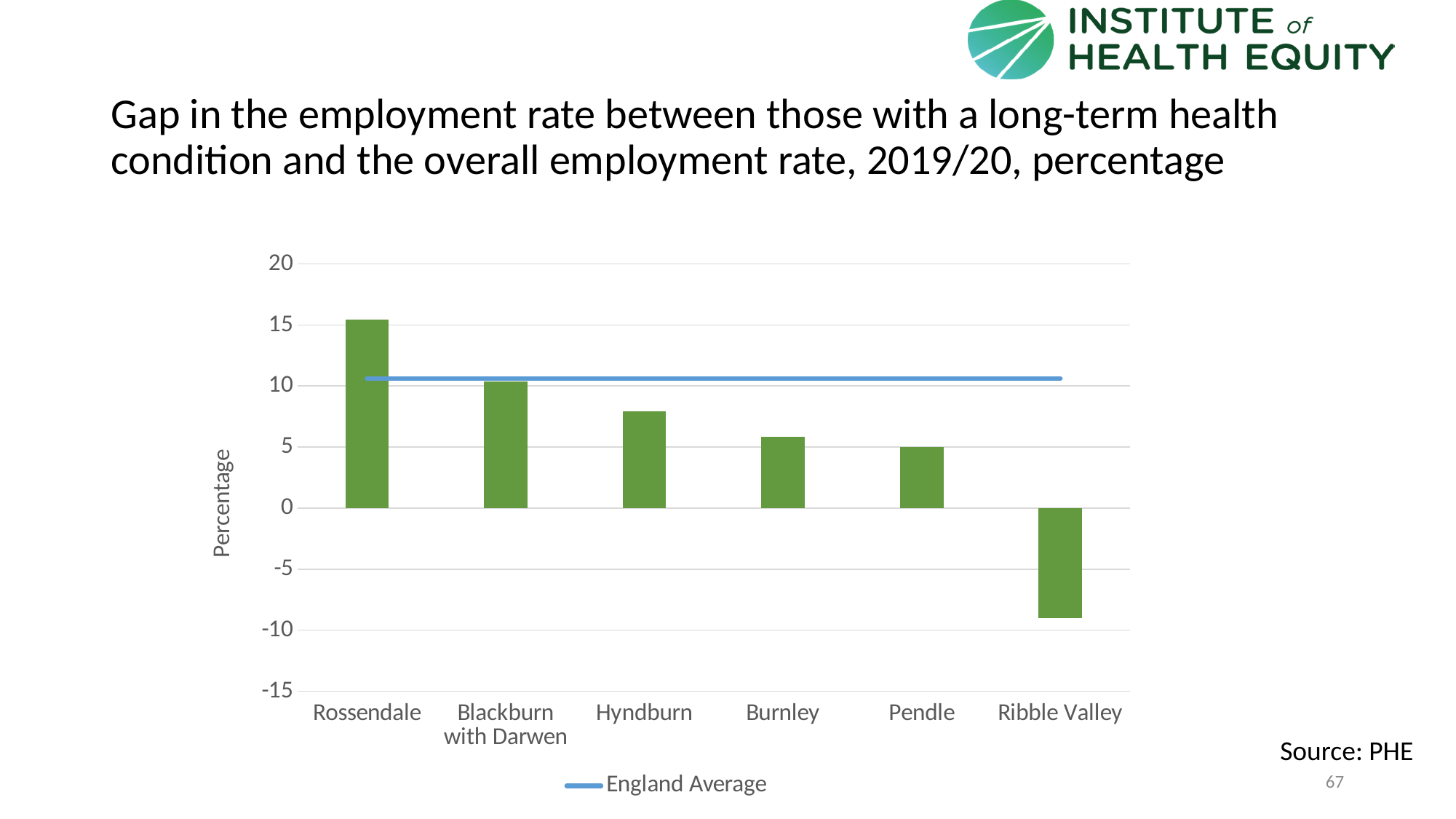
What kind of chart is shown on the slide? combination bar and line chart Which local authority has the highest value in the chart? Rossendale Is the value for Burnley greater or less than 5? greater What series does the legend of the chart list? England Average What is the label on the vertical axis of the chart? Percentage Which local authority has the lowest value in the chart? Ribble Valley Is the value for Hyndburn greater or less than 10? less How many local authorities are shown on the x axis of the chart? 6 Do the bar values rise or fall moving from left to right along the x axis? fall Which is larger, the value for Hyndburn or the value for Pendle? Hyndburn Is the value for Ribble Valley greater or less than -5? less